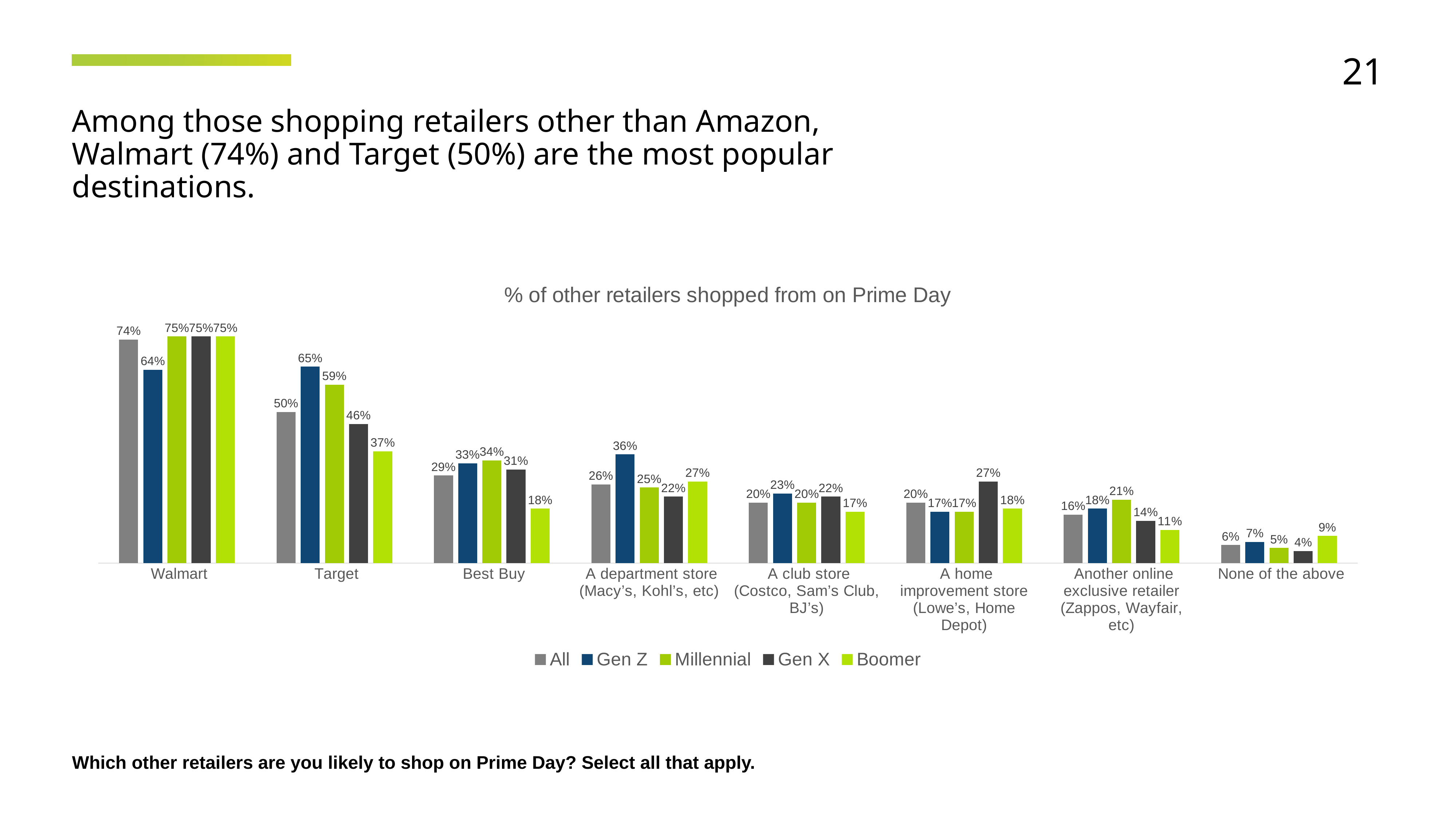
What is the title of the chart? % of other retailers shopped from on Prime Day What kind of chart is shown on the slide? Bar chart What is the value for All at Walmart? 74% What is the difference between the Gen Z and Boomer values at Target? 28% What is the value for Gen Z at Target? 65% How many series does the legend list? 5 Which is larger at A department store (Macy's, Kohl's, etc): the Gen Z value or the Gen X value? Gen Z Which category has the lowest value for the All series? None of the above Which category has the highest value for the Gen Z series? Target What is the value for Boomer at Best Buy? 18% How many categories are shown on the x axis? 8 What is the value for Gen X at A home improvement store (Lowe's, Home Depot)? 27%